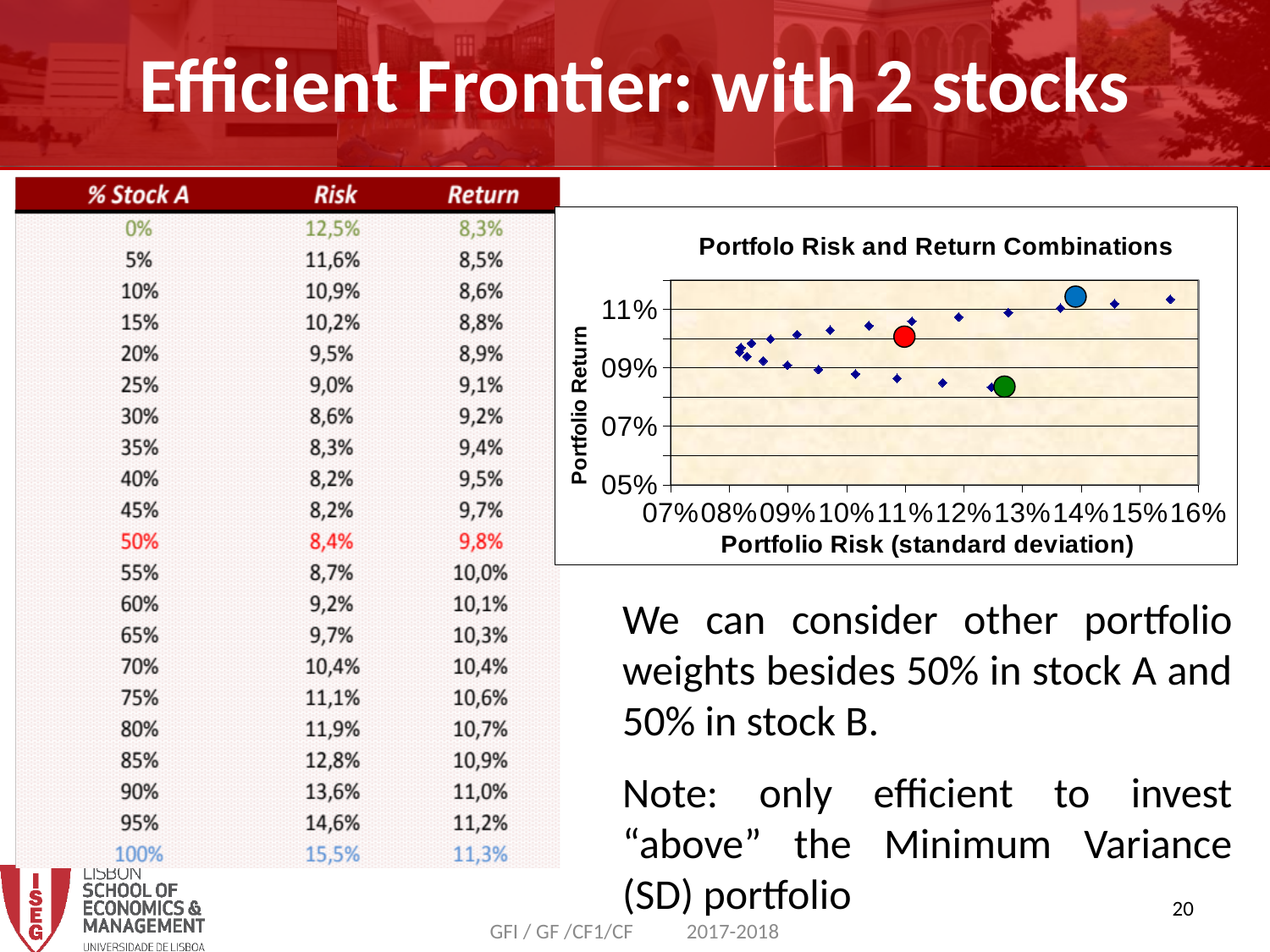
What is the label of the horizontal axis of the chart? Portfolio Risk (standard deviation) What is the highest value shown on the vertical axis of the chart? 11% Is the portfolio risk of the green marker on the chart greater or less than 12%? greater Which of the highlighted markers has the lower portfolio risk, the red one or the blue one? the red one Is the portfolio risk of the red marker on the chart greater or less than 10%? greater What kind of chart is shown on the slide? scatter chart Is the portfolio return of the red marker on the chart greater or less than 09%? greater Along the upper branch of points, does portfolio return rise or fall as portfolio risk increases from 08% to 16%? rise What is the title of the chart on the slide? Portfolo Risk and Return Combinations Which of the highlighted markers has the higher portfolio return, the blue one or the green one? the blue one